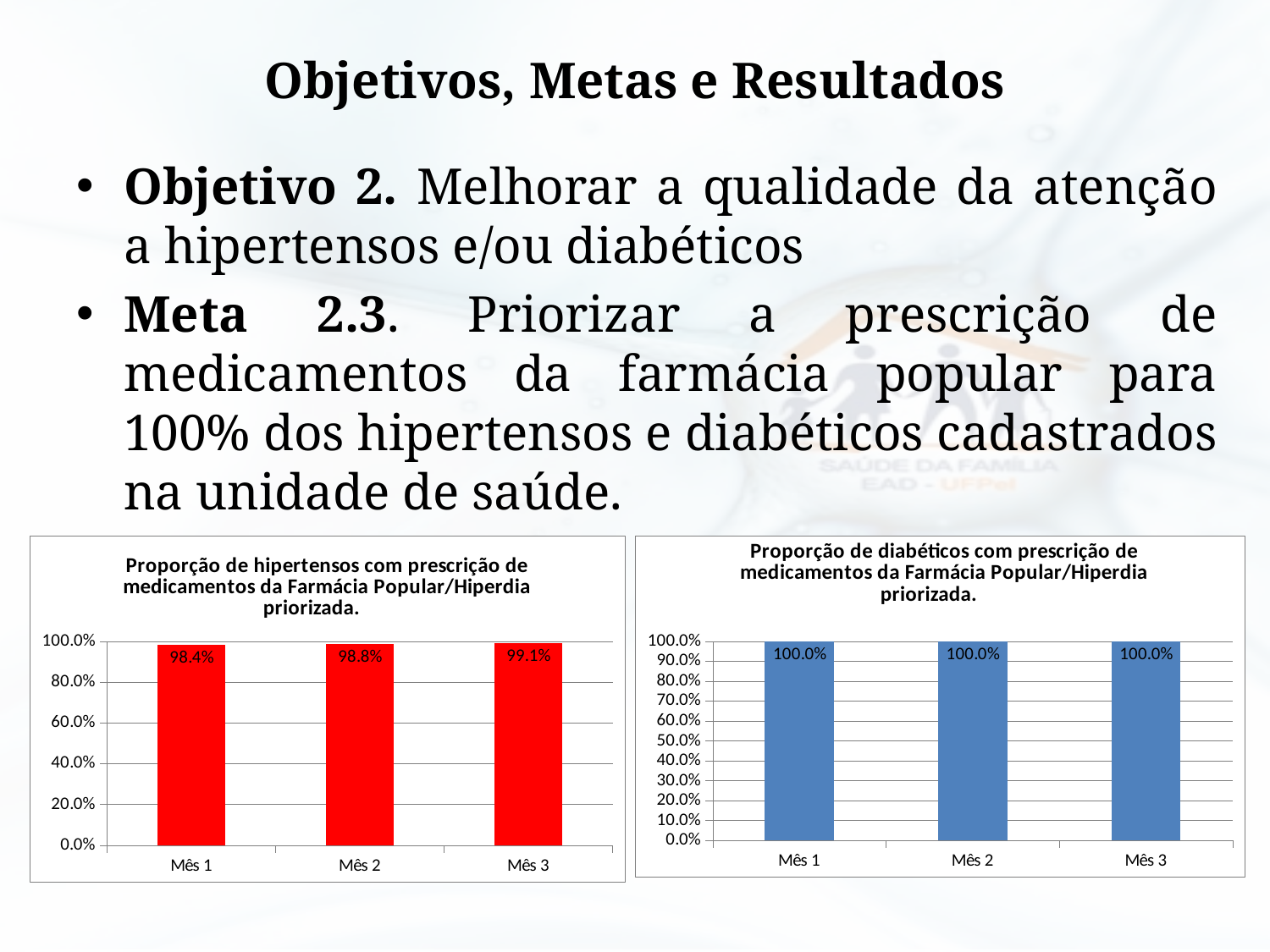
How many months are shown in the right chart (diabéticos)? 3 In the left chart (hipertensos), what is the value for Mês 3? 99.1% In the left chart (hipertensos), do the values rise or fall from Mês 1 to Mês 3? rise In the right chart (diabéticos), what is the value for Mês 2? 100.0% What kind of chart is the left chart (hipertensos)? bar chart In the left chart (hipertensos), what is the difference between the values for Mês 3 and Mês 1? 0.7% In the left chart (hipertensos), which month has the highest value? Mês 3 In the right chart (diabéticos), is the value for Mês 1 greater or less than 90.0%? greater In the left chart (hipertensos), which is larger, the value for Mês 2 or Mês 1? Mês 2 In the left chart (hipertensos), what is the value for Mês 1? 98.4% In the left chart (hipertensos), which month has the lowest value? Mês 1 What colour are the bars in the right chart (diabéticos)? blue